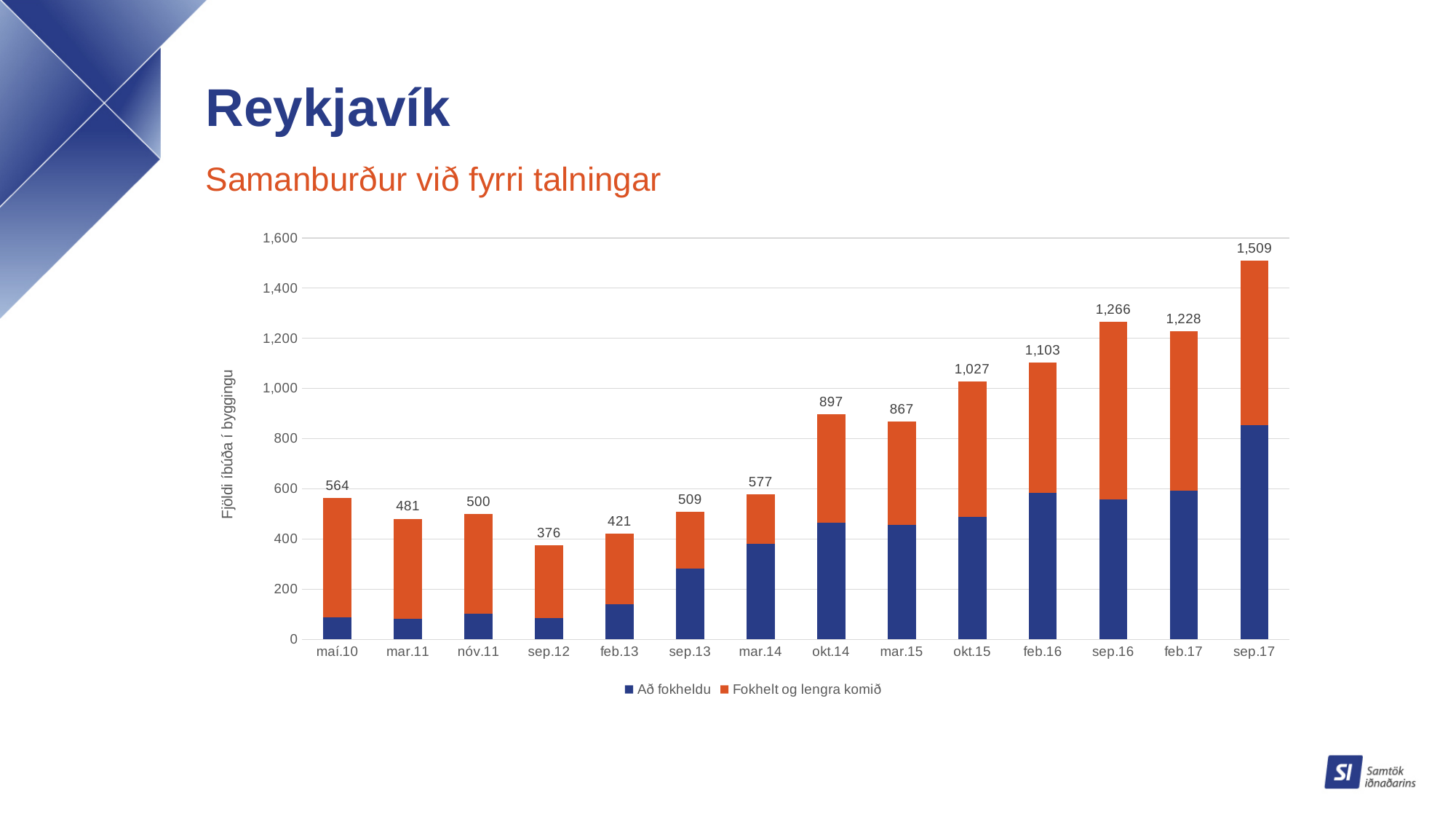
What is the total value labelled above the bar for okt.14? 897 What is the difference between the total for okt.15 and the total for mar.15? 160 How many series does the legend list? 2 Which period has the highest total value? sep.17 Is the 'Að fokheldu' value for sep.17 greater or less than 800? greater Is the 'Að fokheldu' value for maí.10 greater or less than 200? less What is the total number of apartments under construction shown for sep.17? 1,509 Which period has the lowest total value? sep.12 What is the difference between the total for sep.17 and the total for feb.17? 281 How many periods are shown on the x axis? 14 Which has a larger total, sep.16 or feb.17? sep.16 What kind of chart is shown on the slide? Stacked bar chart